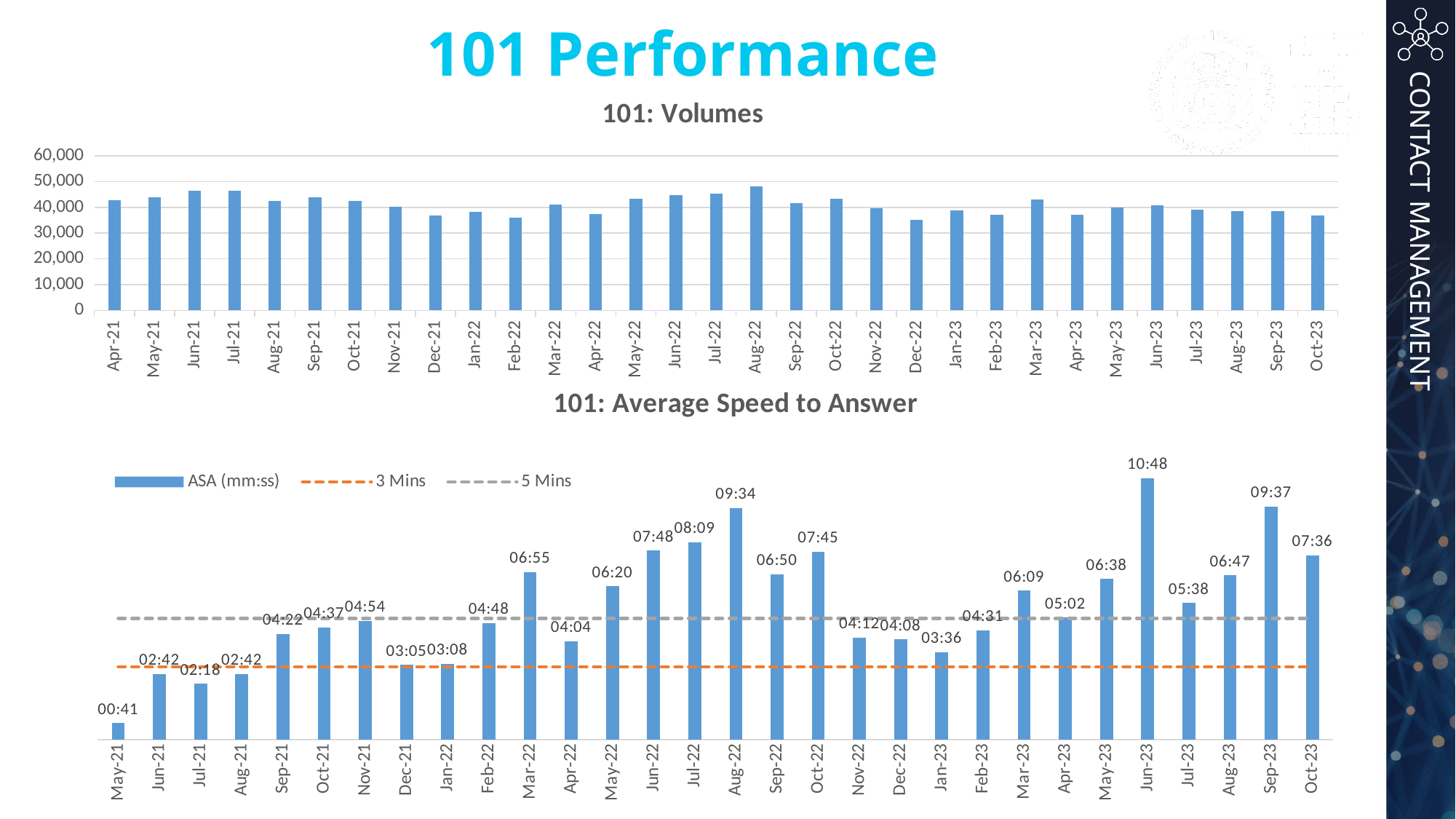
On the '101: Average Speed to Answer' chart, which is larger, the ASA for Aug-22 or Sep-23? Sep-23 On the '101: Average Speed to Answer' chart, which month has the highest ASA? Jun-23 On the '101: Average Speed to Answer' chart, what is the difference between the ASA for Jun-23 and Sep-23? 01:11 On the '101: Volumes' chart, is the value for Dec-22 greater or less than 40,000? less On the '101: Average Speed to Answer' chart, how many entries does the legend list? 3 On the '101: Average Speed to Answer' chart, what is the ASA for Aug-22? 09:34 What kind of chart is '101: Volumes'? bar chart On the '101: Average Speed to Answer' chart, which month has the lowest ASA? May-21 On the '101: Volumes' chart, how many months are plotted? 31 On the '101: Volumes' chart, is the value for Aug-22 greater or less than 40,000? greater On the '101: Volumes' chart, which month has the highest volume? Aug-22 On the '101: Average Speed to Answer' chart, what is the ASA for Jun-23? 10:48